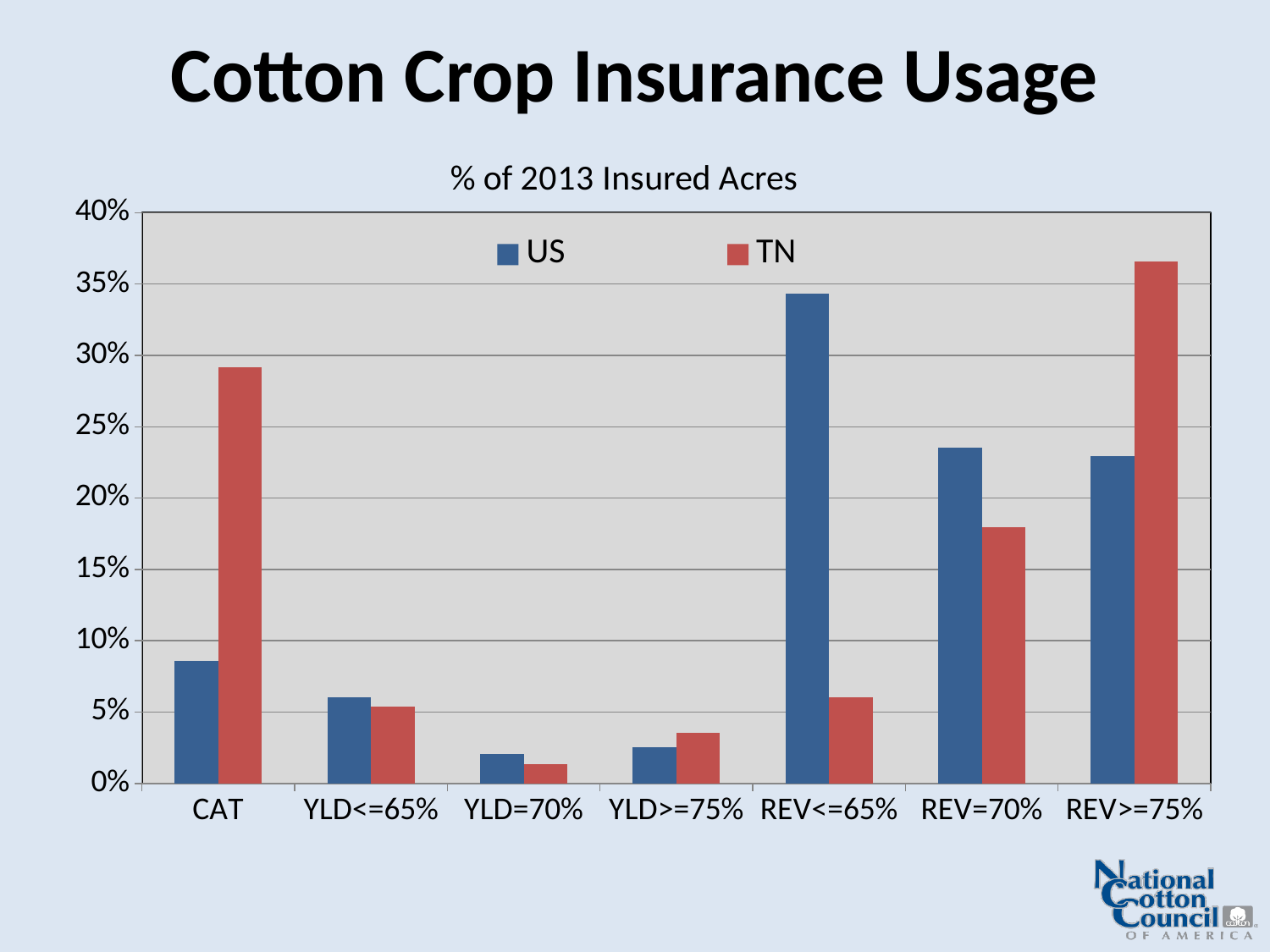
For the CAT category, which is larger, the US value or the TN value? TN Which category has the highest US value? REV<=65% Which category has the lowest TN value? YLD=70% What is the subtitle shown above the chart? % of 2013 Insured Acres Is the US value for REV<=65% greater or less than 30%? greater For the REV<=65% category, which is larger, the US value or the TN value? US Is the TN value for CAT greater or less than 25%? greater Which category has the highest TN value? REV>=75% How many categories are shown on the x axis? 7 What kind of chart is shown on the slide? bar chart Is the TN value for REV=70% greater or less than 20%? less How many series does the legend list? 2